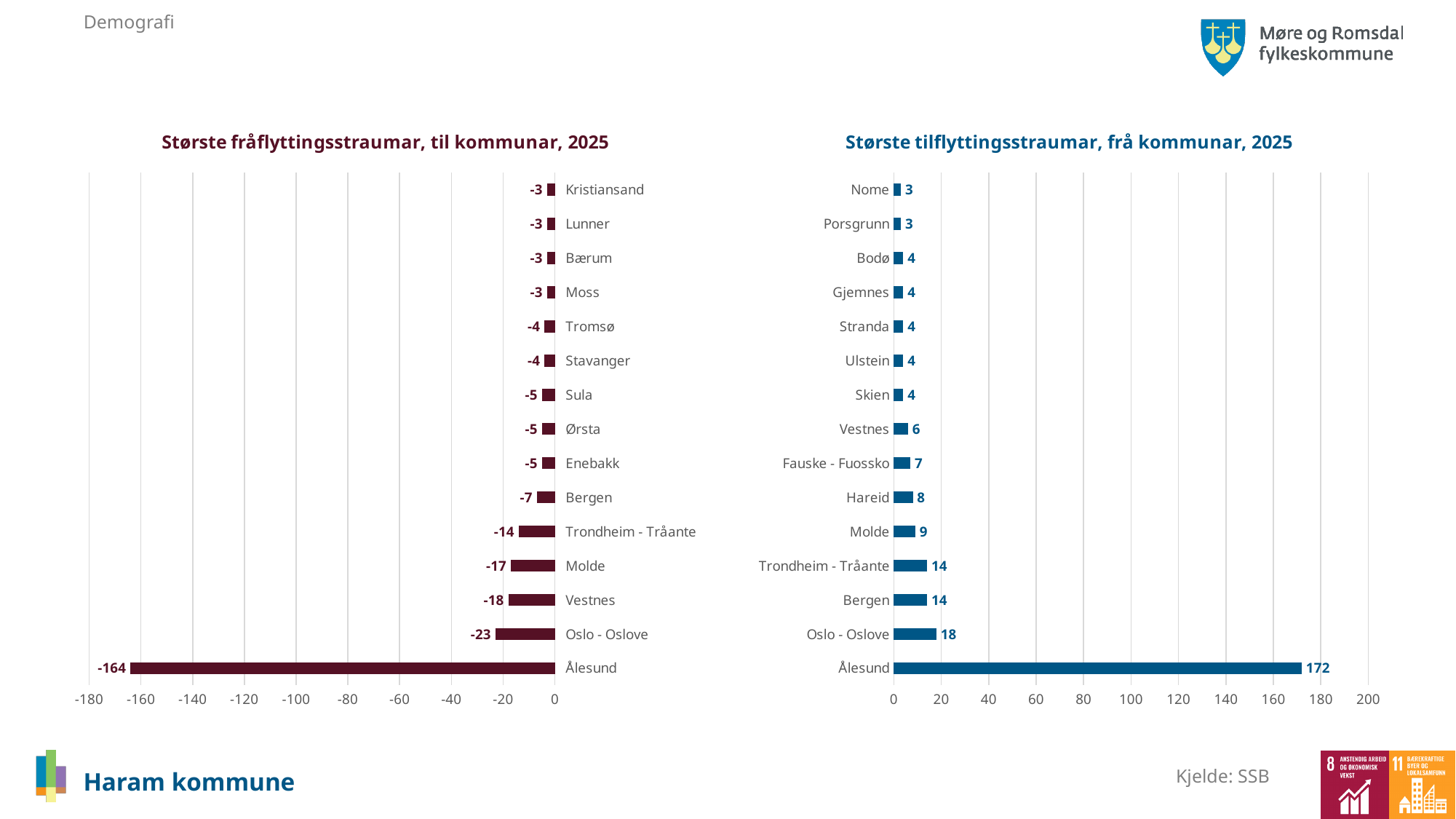
In the chart 'Største tilflyttingsstraumar, frå kommunar, 2025', what is the difference between the values for Ålesund and Oslo - Oslove? 154 In the chart 'Største fråflyttingsstraumar, til kommunar, 2025', what is the value for Ålesund? -164 How many municipalities are shown in the chart 'Største tilflyttingsstraumar, frå kommunar, 2025'? 15 In the chart 'Største tilflyttingsstraumar, frå kommunar, 2025', which has a larger value, Molde or Vestnes? Molde In the chart 'Største fråflyttingsstraumar, til kommunar, 2025', which municipality has the lowest (most negative) value? Ålesund In the chart 'Største fråflyttingsstraumar, til kommunar, 2025', what is the value for Molde? -17 In the chart 'Største tilflyttingsstraumar, frå kommunar, 2025', which municipality has the highest value? Ålesund In the chart 'Største tilflyttingsstraumar, frå kommunar, 2025', what is the value for Oslo - Oslove? 18 In the chart 'Største fråflyttingsstraumar, til kommunar, 2025', what is the difference between the values for Vestnes and Molde? 1 In the chart 'Største tilflyttingsstraumar, frå kommunar, 2025', is the value for Ålesund greater or less than 160? greater In the chart 'Største tilflyttingsstraumar, frå kommunar, 2025', what is the value for Hareid? 8 What type of chart is 'Største fråflyttingsstraumar, til kommunar, 2025'? Bar chart